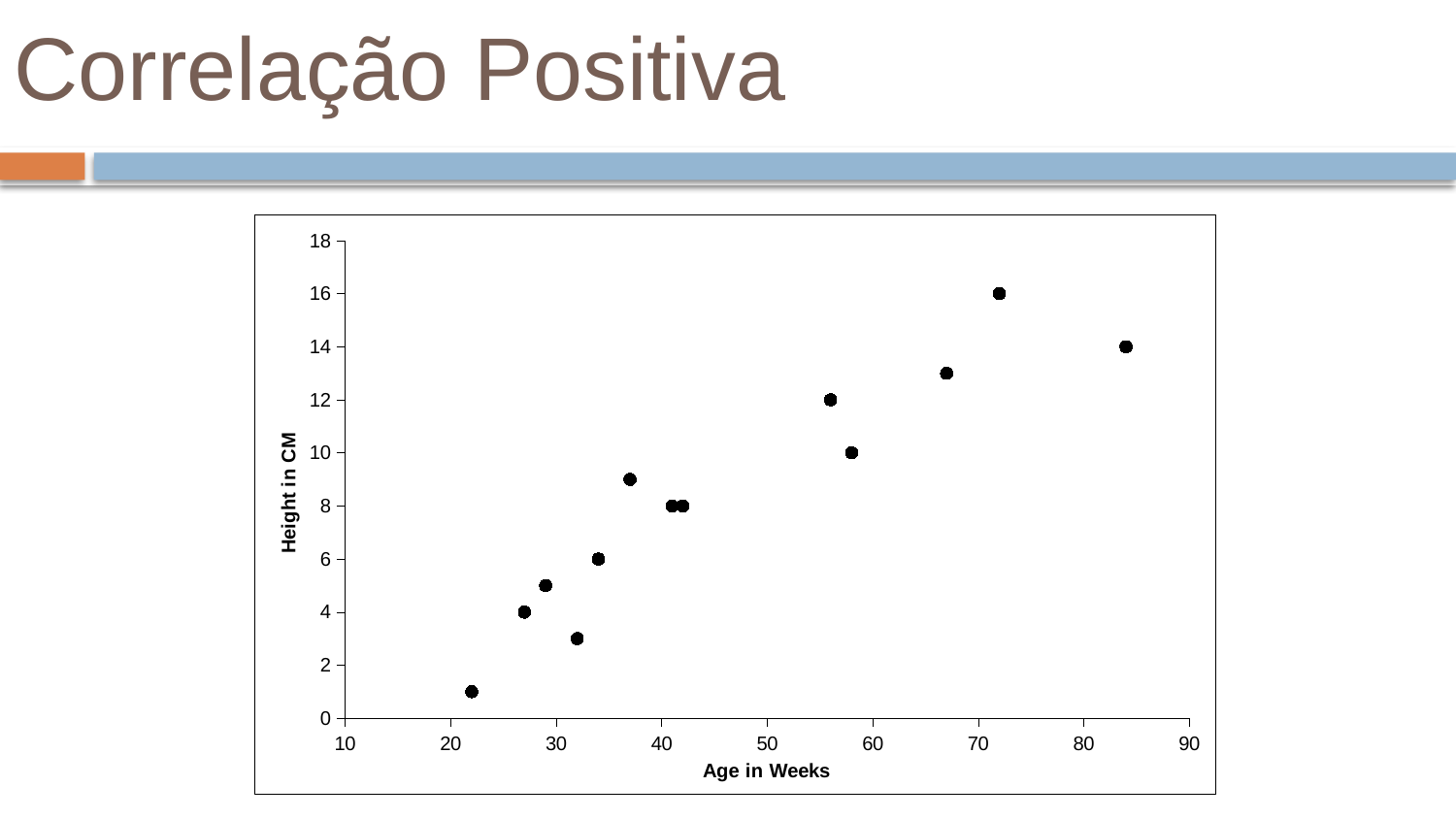
How many points have a height greater than 10 cm? 4 Is the height of the leftmost point (at about 22 weeks) greater or less than 2? less What is the label of the x axis? Age in Weeks What is the height value of the highest point on the chart? 16 Do the height values generally rise or fall as age in weeks increases? rise What is the label of the y axis? Height in CM Is the height of the point at about 37 weeks greater or less than 8? greater Is the height of the rightmost point (at about 84 weeks) greater or less than 12? greater How many data points are plotted on the chart? 13 Which point has the greater height: the one at about 72 weeks or the one at about 84 weeks? the one at about 72 weeks What kind of chart is shown on the slide? scatter plot